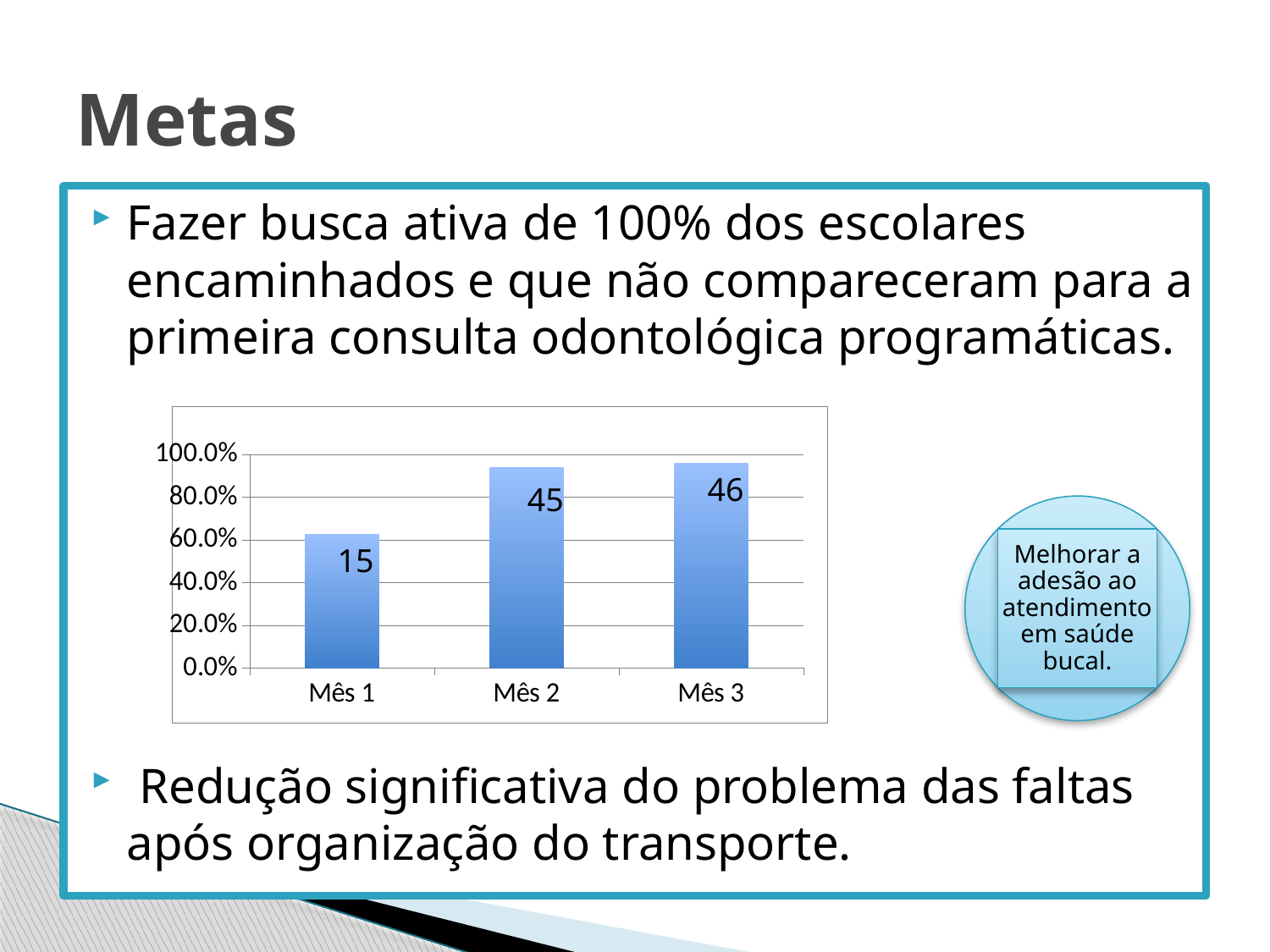
What is the difference between the data labels for Mês 3 and Mês 1? 31 What is the data label shown on the bar for Mês 2? 45 Which month has the lowest bar in the chart? Mês 1 How many months are shown on the x axis of the chart? 3 Which is larger, the value for Mês 2 or the value for Mês 1? Mês 2 What kind of chart is shown on the slide? Bar chart Is the bar for Mês 1 greater or less than 80.0% on the axis? less What is the data label shown on the bar for Mês 3? 46 Which month has the highest bar in the chart? Mês 3 Is the bar for Mês 2 greater or less than 80.0% on the axis? greater What is the difference between the data labels for Mês 2 and Mês 1? 30 What is the data label shown on the bar for Mês 1? 15